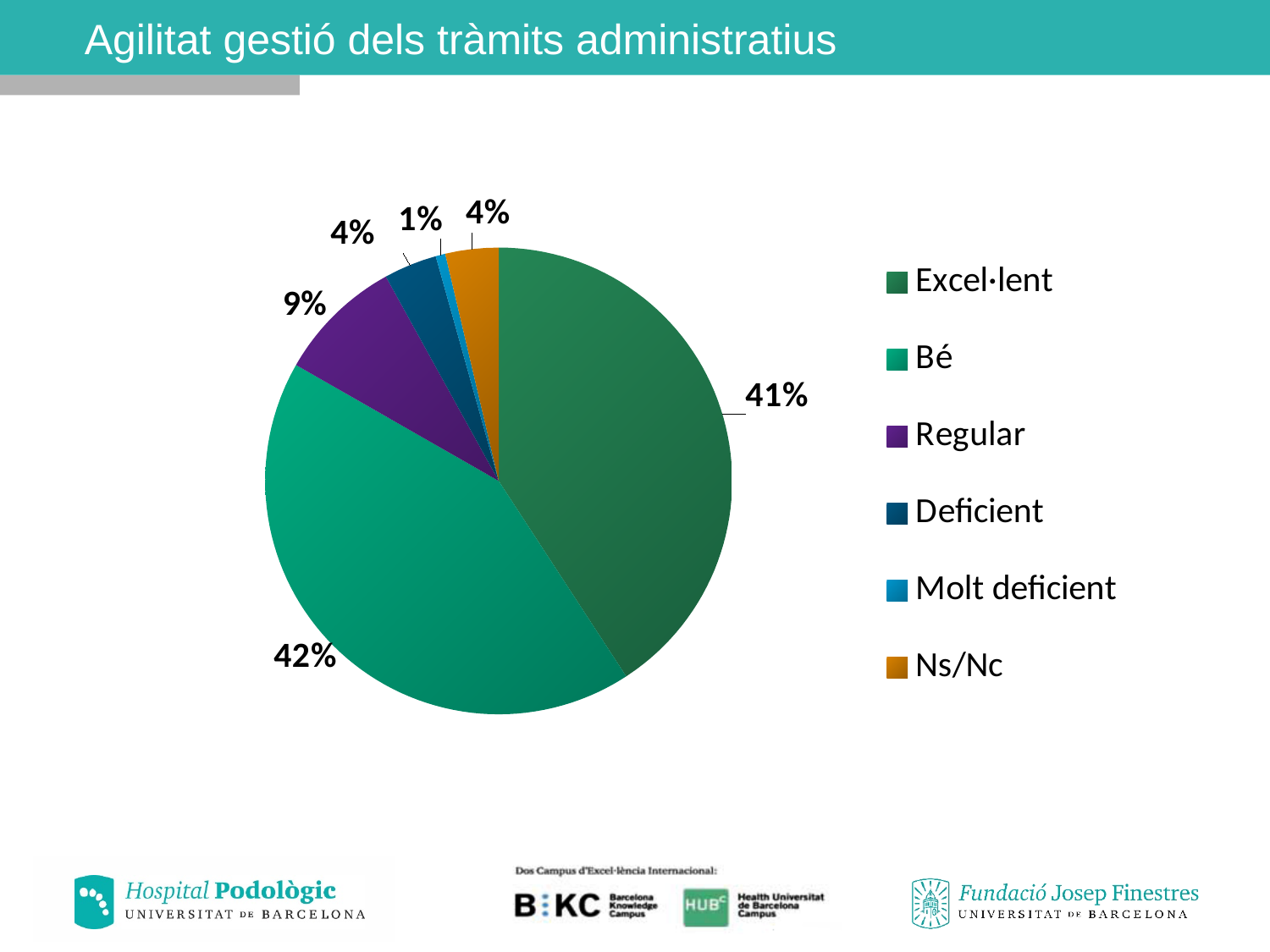
Which legend entry is shown in orange? Ns/Nc What is the title of the slide containing the chart? Agilitat gestió dels tràmits administratius What percentage is shown for Molt deficient? 1% What share does the Excel·lent slice have in the pie chart? 41% How many categories does the pie chart show? 6 What percentage of the pie chart is labelled Bé? 42% What is the value shown for Regular in the pie chart? 9% Which category has the largest slice in the pie chart? Bé What type of chart is shown on the slide? Pie chart Which category has the smallest slice in the pie chart? Molt deficient What is the difference in percentage points between the Bé slice and the Regular slice? 33% Which slice is larger, Regular or Deficient? Regular